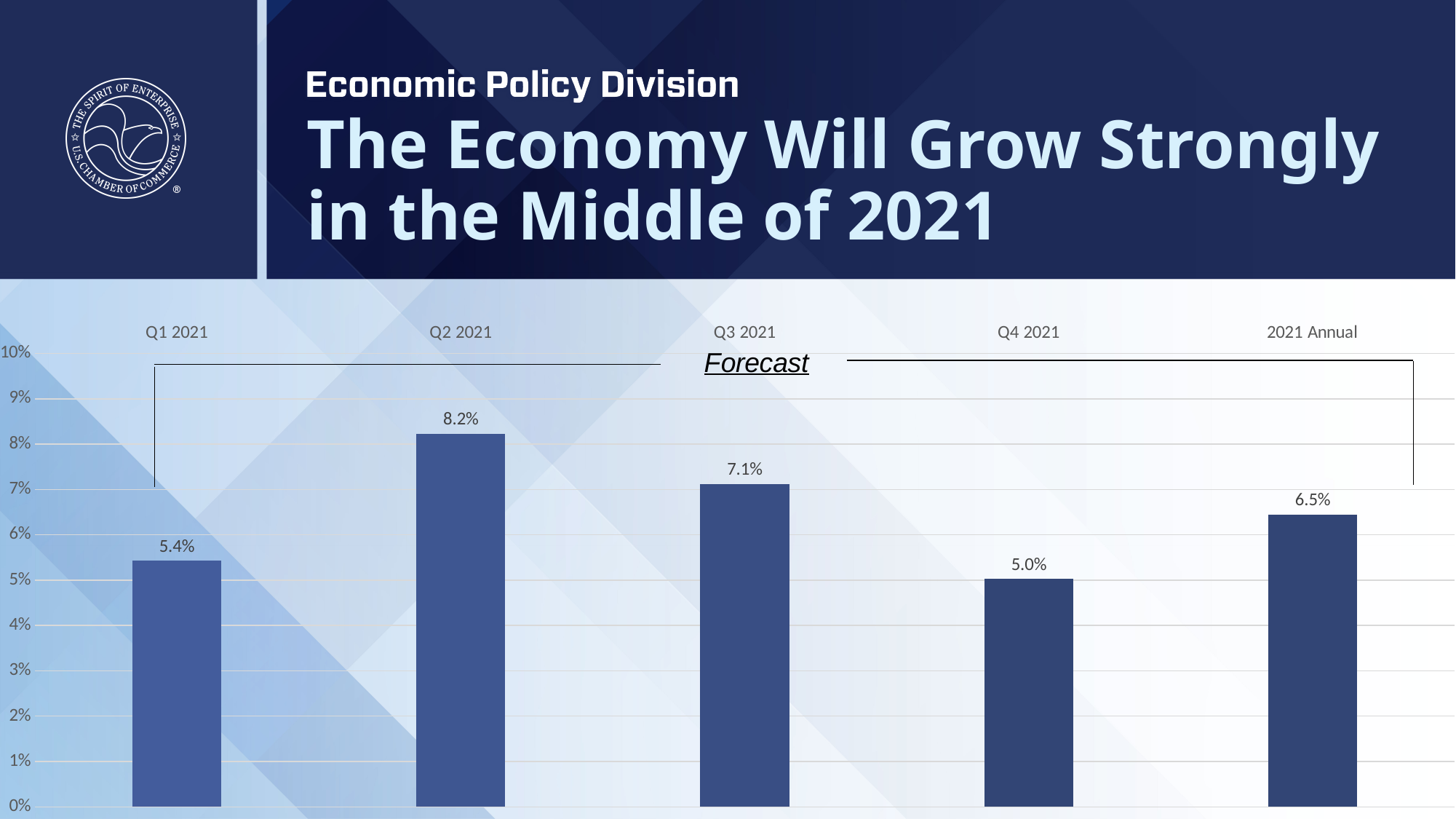
What is the value for 2021 Annual? 6.5% What is the difference between the values for Q2 2021 and Q4 2021? 3.2% What label is written above the bracket spanning the bars on the chart? Forecast What is the value for Q2 2021? 8.2% What is the value for Q1 2021? 5.4% Which category has the lowest value? Q4 2021 Which category has the highest value? Q2 2021 What kind of chart is shown on the slide? Bar chart Which is larger, the value for Q3 2021 or the value for 2021 Annual? Q3 2021 What is the value for Q4 2021? 5.0% What is the value for Q3 2021? 7.1% How many categories are shown on the x axis? 5